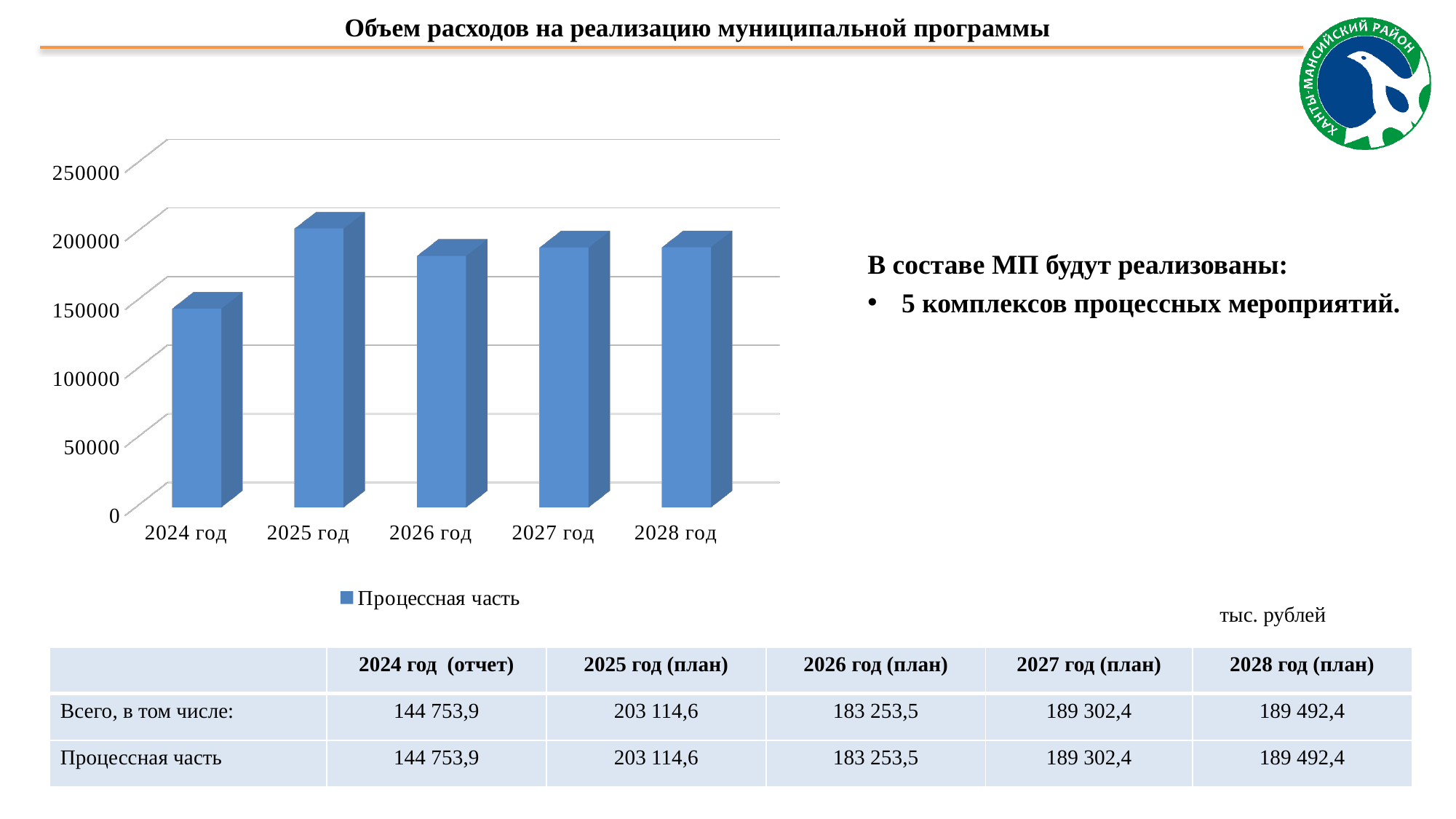
Which year has the highest bar on the chart? 2025 год Is the value for 2025 год greater or less than 200000? greater Is the value for 2026 год greater or less than 200000? less Which year has the lowest bar on the chart? 2024 год Does the value rise or fall from 2024 год to 2025 год? rise What kind of chart is shown on the slide? bar chart Is the value for 2024 год greater or less than 150000? less How many years (categories) are plotted on the chart? 5 Which is larger, the value for 2025 год or the value for 2026 год? 2025 год According to the table on the slide, what is the value of Процессная часть for 2025 год (план)? 203 114,6 How many series does the chart legend list? 1 What is the name of the series shown in the chart legend? Процессная часть